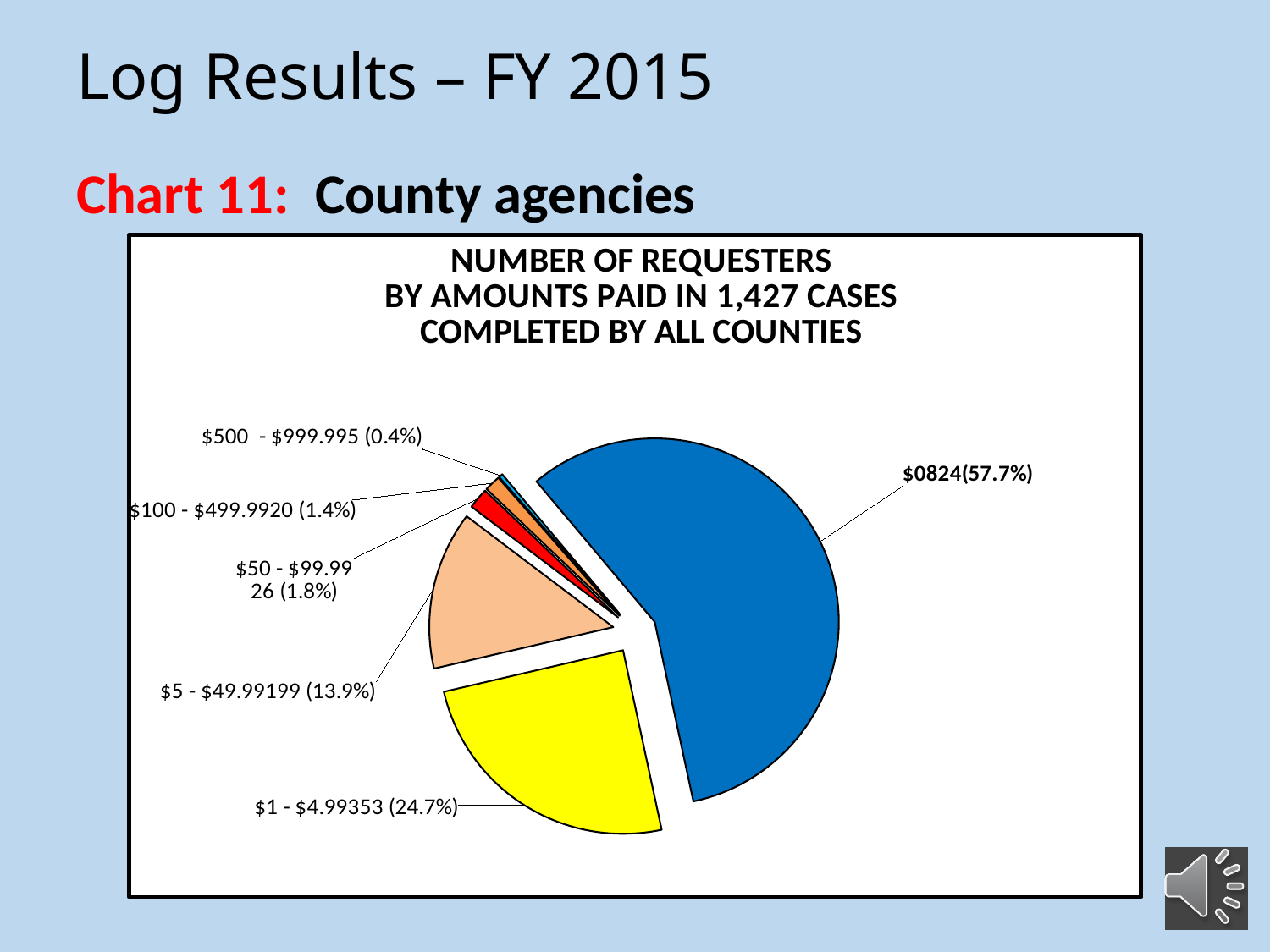
How many requesters are in the $50 - $99.99 category? 26 Which amount range has the smallest slice of the pie? $500 - $999.99 (0.4%) According to the chart title, how many cases were completed by all counties? 1,427 What percentage is shown for the largest slice of the pie? 57.7% What is the difference in percentage points between the $1 - $4.99 slice and the $5 - $49.99 slice? 10.8 percentage points What share of the pie does the $5 - $49.99 slice represent? 13.9% What share of the pie does the $100 - $499.99 slice represent? 1.4% What kind of chart is shown on the slide? Pie chart What share of the pie does the $1 - $4.99 slice represent? 24.7% Which slice is larger: $1 - $4.99 or $5 - $49.99? $1 - $4.99 How many slices does the pie chart have? 6